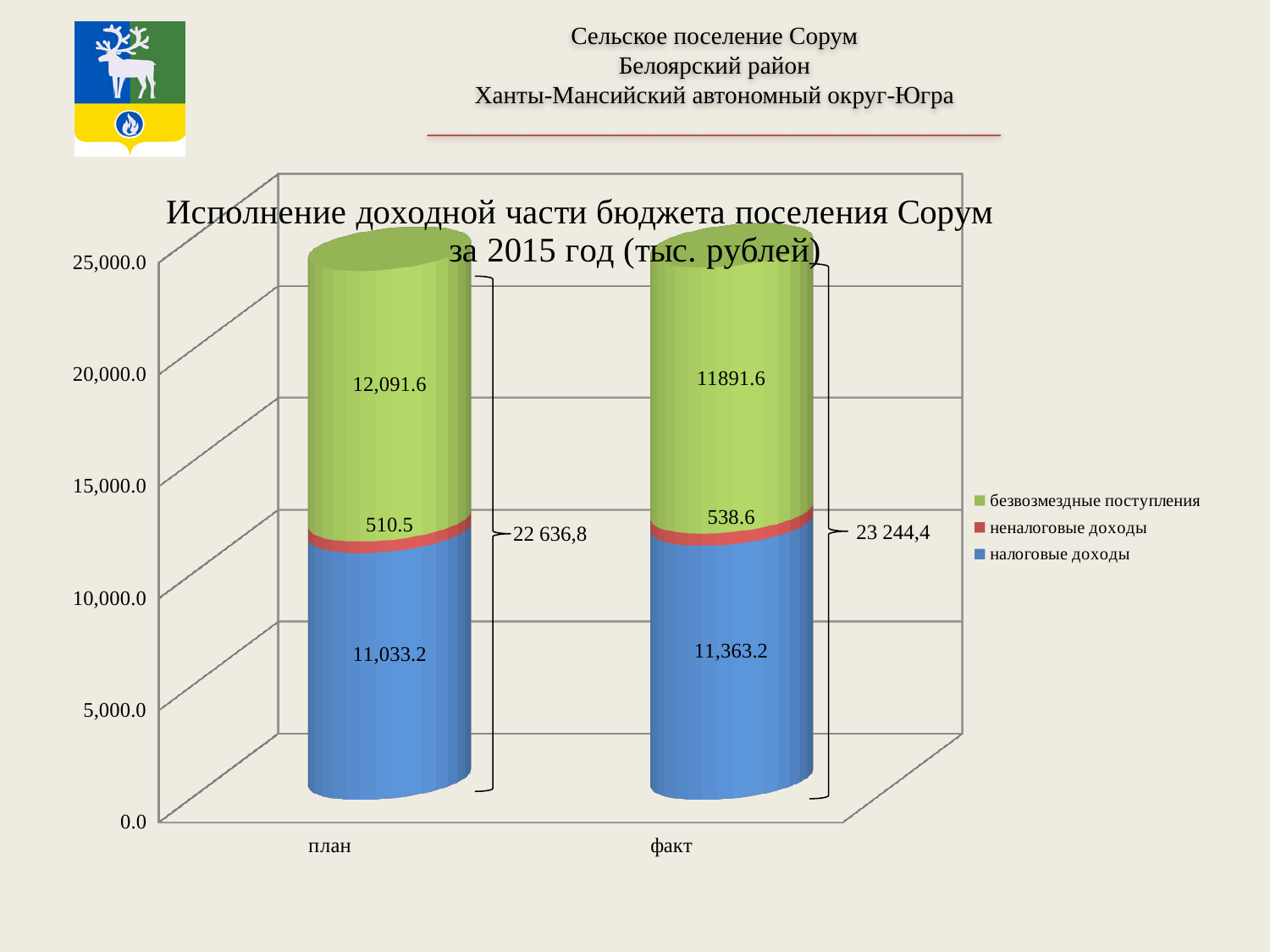
What is the value of безвозмездные поступления for факт? 11891.6 What is the value of неналоговые доходы for факт? 538.6 What is the total of the stacked bar for план, as labelled on the slide? 22 636,8 What is the value of налоговые доходы for план? 11,033.2 What is the value of неналоговые доходы for план? 510.5 What is the difference between налоговые доходы for факт and for план? 330.0 What kind of chart is shown on the slide? stacked bar chart What is the total of the stacked bar for факт, as labelled on the slide? 23 244,4 How many categories are shown on the x axis? 2 How many series does the legend list? 3 Which is larger: налоговые доходы for план or for факт? факт Which is larger: безвозмездные поступления for план or for факт? план